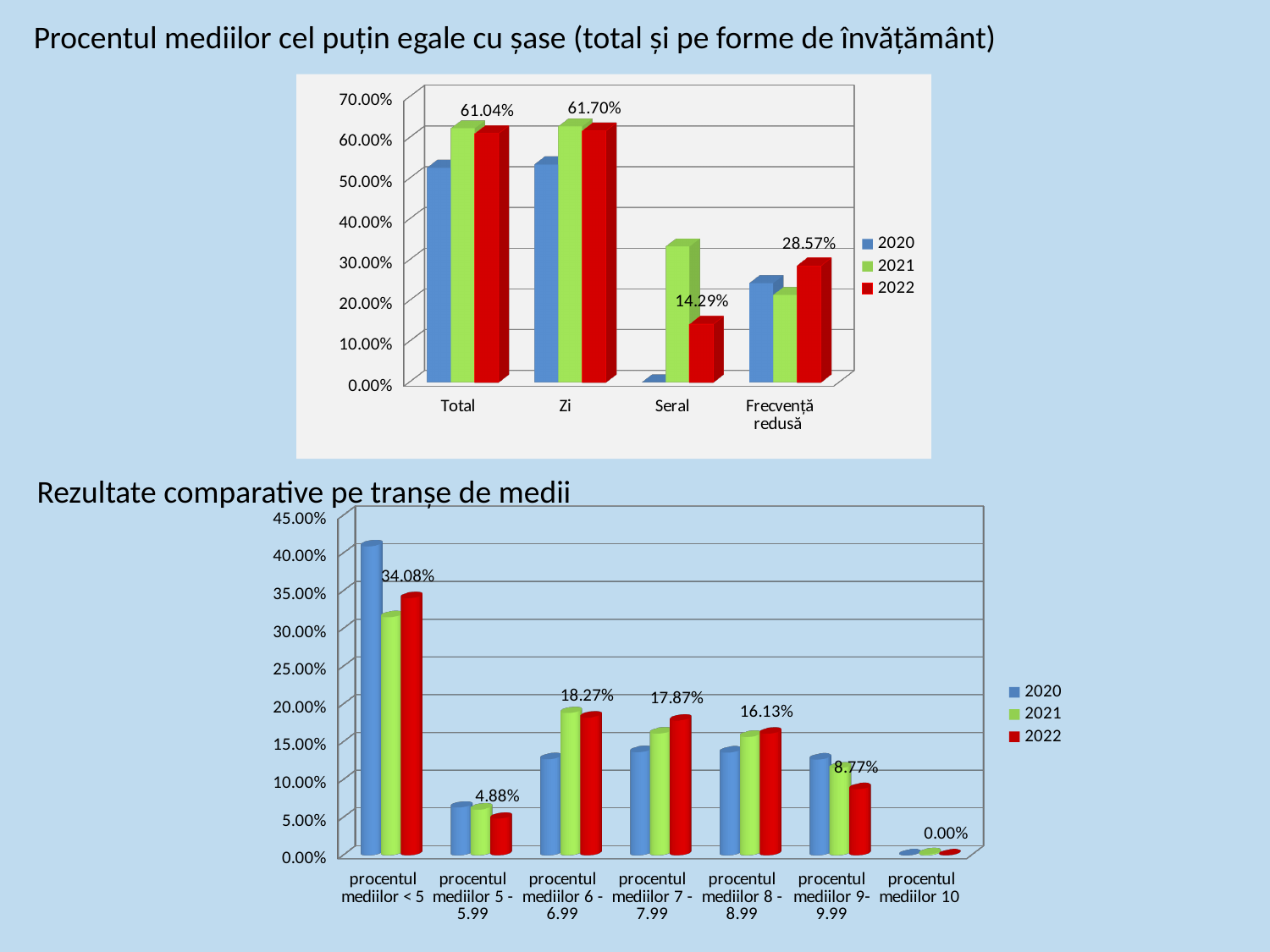
In the bottom chart (Rezultate comparative pe tranșe de medii), what is the 2022 value for procentul mediilor 6 - 6.99? 18.27% In the top chart (Procentul mediilor cel puțin egale cu șase), which category has the highest 2022 value? Zi In the bottom chart (Rezultate comparative pe tranșe de medii), is the 2022 value for procentul mediilor 6 - 6.99 larger or smaller than the 2022 value for procentul mediilor 7 - 7.99? larger In the top chart (Procentul mediilor cel puțin egale cu șase), what is the 2022 value for Seral? 14.29% In the top chart (Procentul mediilor cel puțin egale cu șase), what is the difference between the 2022 values for Zi and Total? 0.66% In the top chart (Procentul mediilor cel puțin egale cu șase), what is the 2022 value for Total? 61.04% In the top chart (Procentul mediilor cel puțin egale cu șase), how many series does the legend list? 3 In the bottom chart (Rezultate comparative pe tranșe de medii), how many categories are shown on the x axis? 7 What kind of chart is the bottom chart (Rezultate comparative pe tranșe de medii)? bar chart In the bottom chart (Rezultate comparative pe tranșe de medii), what is the 2022 value for procentul mediilor 10? 0.00% In the top chart (Procentul mediilor cel puțin egale cu șase), is the 2020 value for Total greater or less than 40.00%? greater In the top chart (Procentul mediilor cel puțin egale cu șase), what is the 2022 value for Frecvență redusă? 28.57%